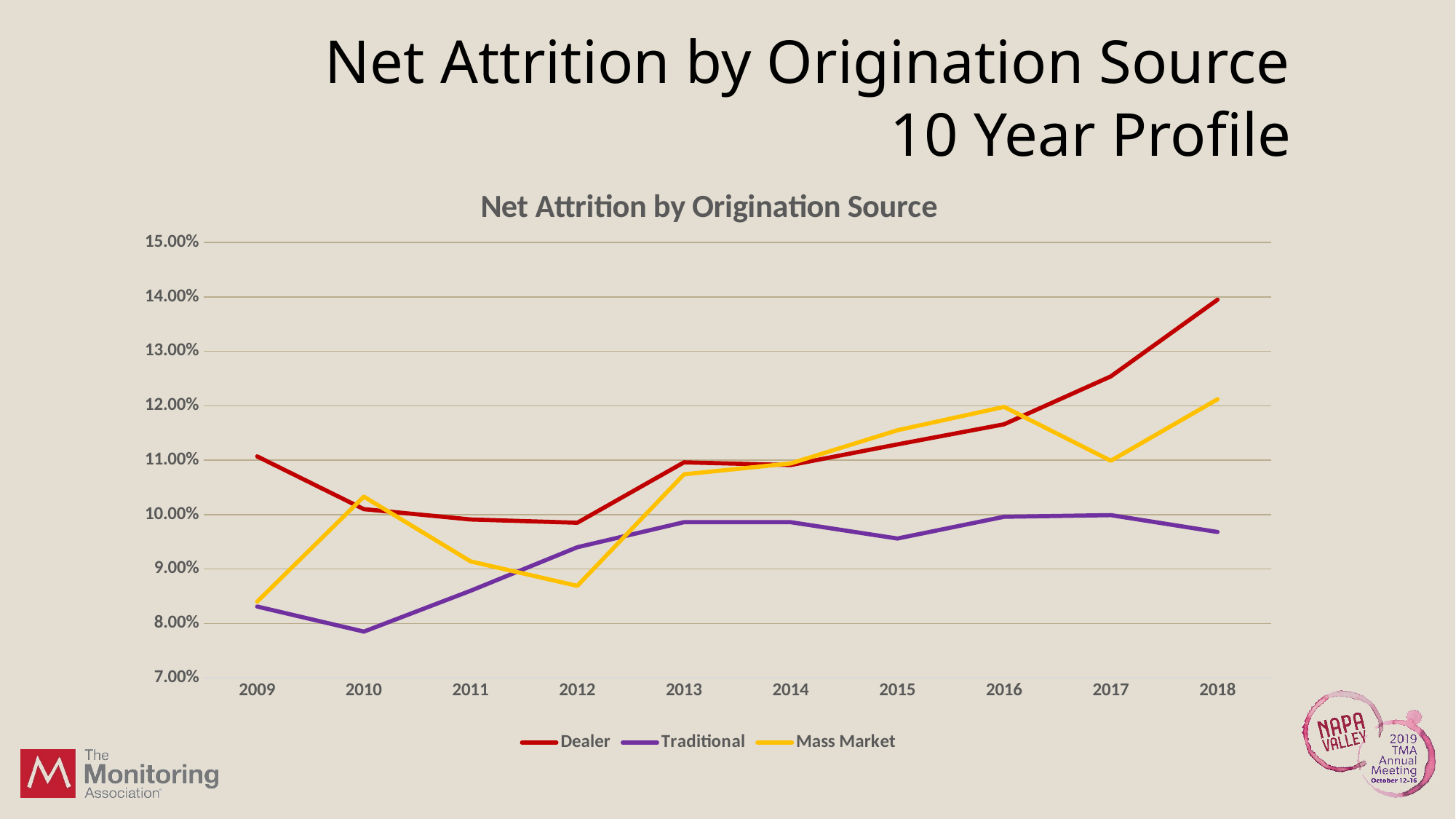
How many series does the legend list? 3 Does the Dealer series rise or fall from 2012 to 2018? Rise What is the title of the chart? Net Attrition by Origination Source In which year is the Traditional series at its lowest? 2010 Which is larger in 2010, Mass Market or Traditional? Mass Market How many years are shown on the x axis? 10 Which series has the highest value in 2018? Dealer Is the value for Dealer in 2018 greater or less than 13.00%? greater What kind of chart is shown on the slide? Line chart In which year is the Dealer series at its highest? 2018 Is the value for Traditional in 2015 greater or less than 10.00%? less Is the value for Mass Market in 2012 greater or less than 9.00%? less